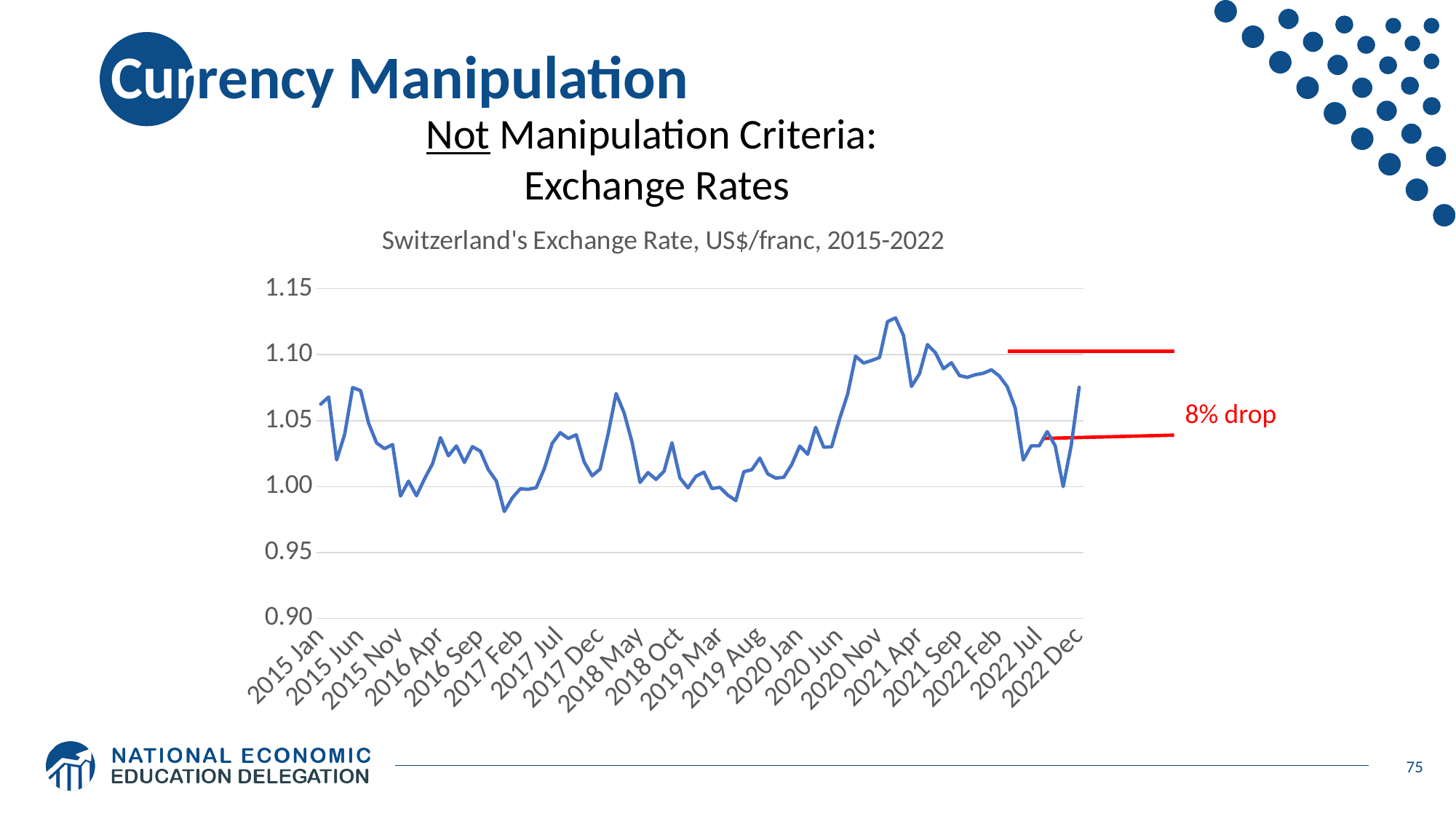
Does the exchange rate rise or fall between 2020 Jun and 2020 Nov? rise Is the value for 2016 Sep greater or less than 1.00? greater What is the title of the chart? Switzerland's Exchange Rate, US$/franc, 2015-2022 What annotation is written in red next to the chart? 8% drop Is the highest point on the line greater or less than 1.10? greater Does the exchange rate rise or fall between 2022 Feb and 2022 Jul? fall What kind of chart is shown on the slide? line chart In which year does the line reach its highest value? 2021 Is the value for 2022 Jul greater or less than 1.05? less